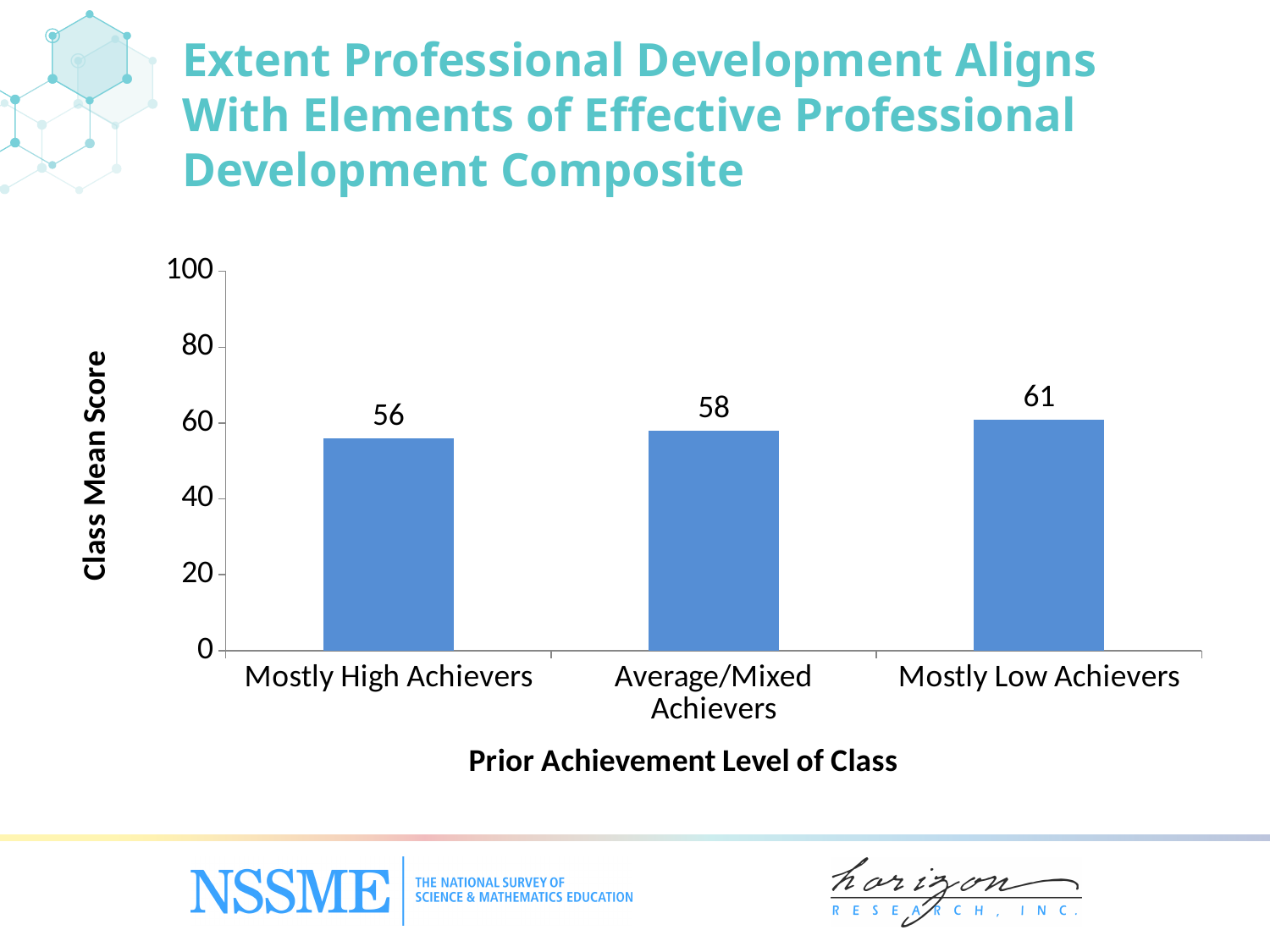
What is the class mean score for Average/Mixed Achievers? 58 What kind of chart is shown on the slide? bar chart What is the class mean score for Mostly Low Achievers? 61 Which has a larger class mean score, Mostly Low Achievers or Average/Mixed Achievers? Mostly Low Achievers Which prior achievement level has the highest class mean score? Mostly Low Achievers Is the value for Mostly High Achievers greater or less than 60? less Do the class mean scores rise or fall moving from Mostly High Achievers to Mostly Low Achievers? rise What is the class mean score for Mostly High Achievers? 56 Which prior achievement level has the lowest class mean score? Mostly High Achievers What is the difference between the class mean scores for Mostly Low Achievers and Mostly High Achievers? 5 What is the difference between the class mean scores for Average/Mixed Achievers and Mostly High Achievers? 2 How many prior achievement level categories are shown in the chart? 3